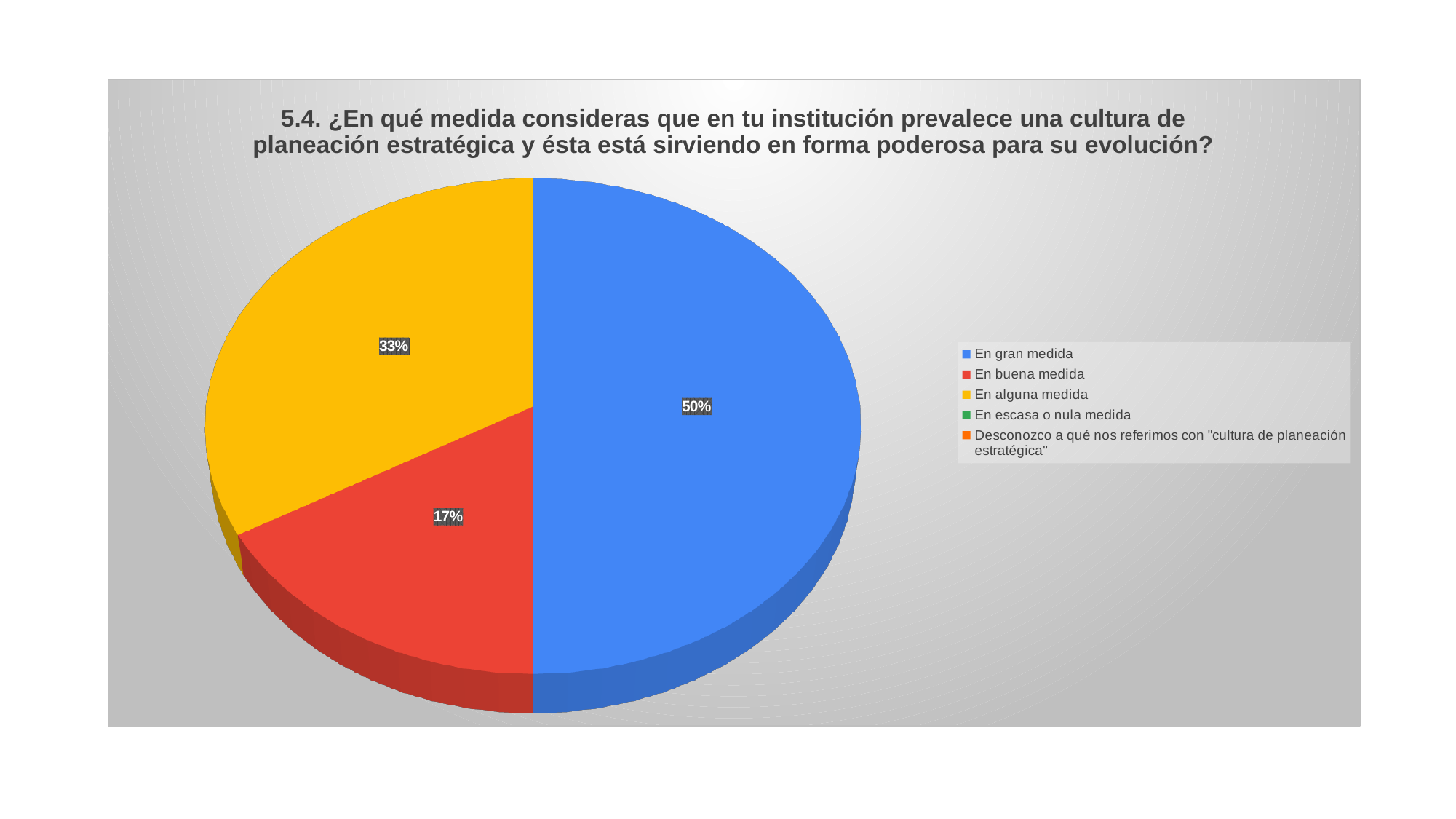
What is the difference in percentage points between "En alguna medida" and "En buena medida"? 16 How many slices with data labels are visible in the pie? 3 What share of the pie does "En buena medida" represent? 17% Which category has the largest slice of the pie? En gran medida Which is larger, the share for "En alguna medida" or the share for "En buena medida"? En alguna medida What share of the pie does "En gran medida" represent? 50% What kind of chart is shown on the slide? pie chart What is the difference in percentage points between "En gran medida" and "En buena medida"? 33 What share of the pie does "En alguna medida" represent? 33% How many entries does the legend list? 5 Among the slices with visible labels, which category has the smallest share? En buena medida What colour is the slice for "En alguna medida"? yellow